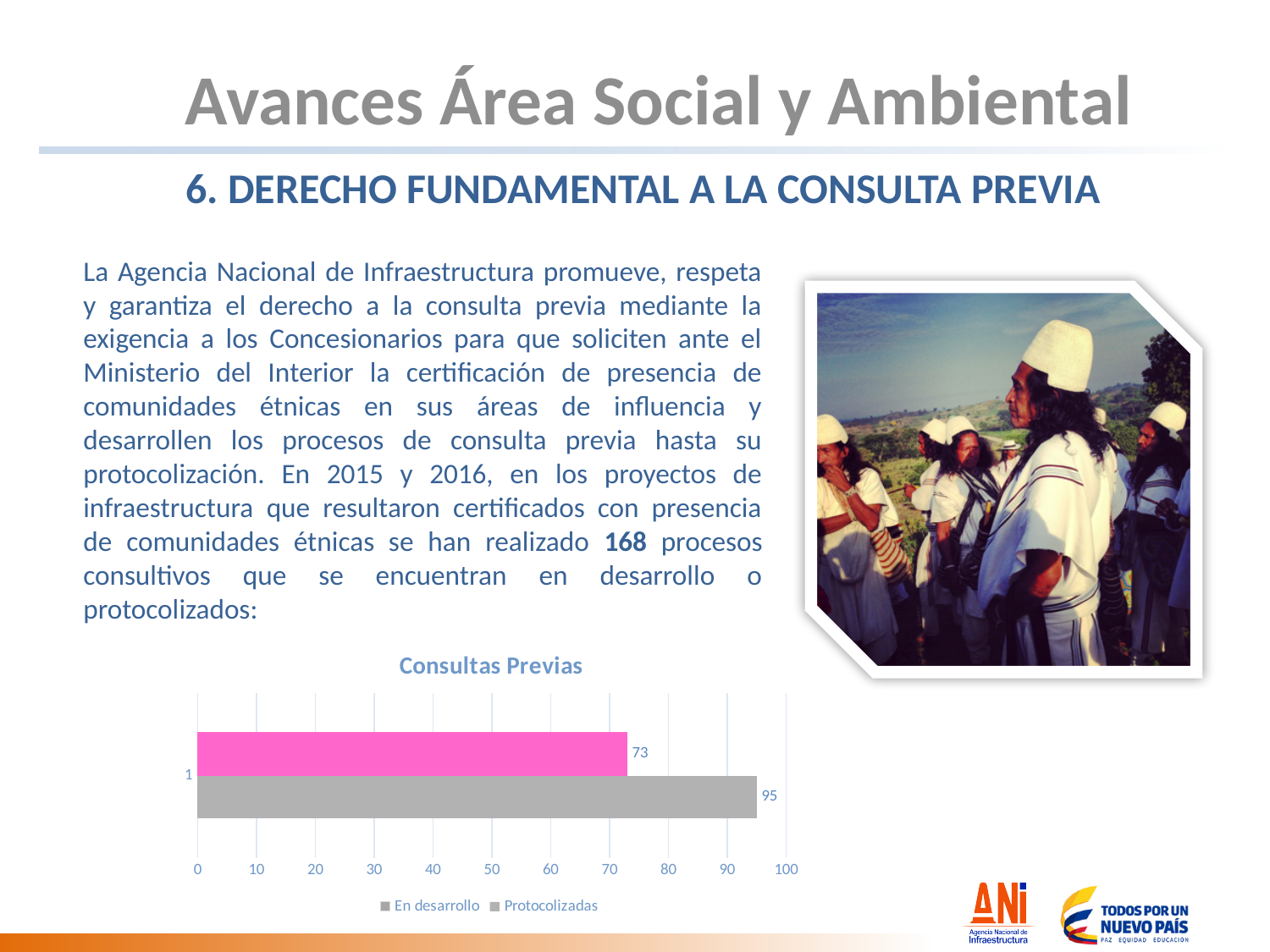
Is the value for Protocolizadas larger or smaller than the value for En desarrollo? larger How many series does the legend of the Consultas Previas chart list? 2 What is the difference between the Protocolizadas value and the En desarrollo value in the Consultas Previas chart? 22 Which series has the lower value in the Consultas Previas chart? En desarrollo What is the value for the 'Protocolizadas' series in the Consultas Previas chart? 95 What type of chart is shown on the slide? bar chart What is the total of the two series values shown in the Consultas Previas chart? 168 What is the title of the chart on the slide? Consultas Previas What is the value for the 'En desarrollo' series in the Consultas Previas chart? 73 Is the value for En desarrollo greater or less than 80? less Is the value for Protocolizadas greater or less than 90? greater Which series has the higher value in the Consultas Previas chart? Protocolizadas